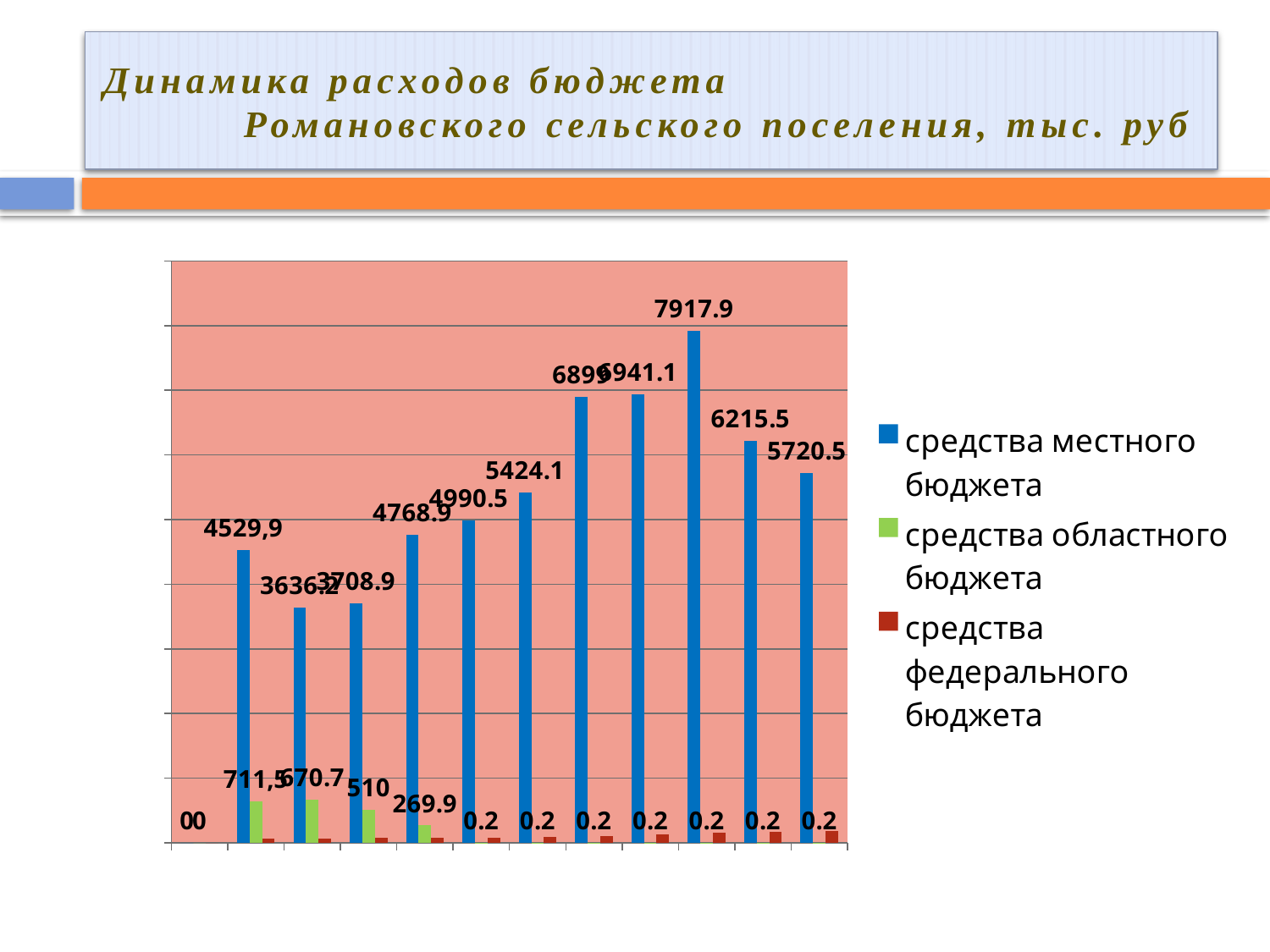
What kind of chart is shown on the slide? bar chart What is the value of the last (rightmost) bar of 'средства местного бюджета'? 5720.5 How many bars are plotted for the series 'средства местного бюджета'? 11 Which colour represents 'средства федерального бюджета' in the legend? red What is the highest value shown for 'средства местного бюджета'? 7917.9 Which series has the tallest bar on the chart: 'средства местного бюджета' or 'средства областного бюджета'? средства местного бюджета How many series does the legend list? 3 What is the highest value shown for 'средства областного бюджета'? 711,5 What is the difference between the highest and lowest values of 'средства местного бюджета'? 4281.7 What is the title of the chart on the slide? Динамика расходов бюджета Романовского сельского поселения, тыс. руб Do the values of 'средства областного бюджета' rise or fall from left to right across the chart? fall What is the lowest value shown for 'средства местного бюджета'? 3636.2